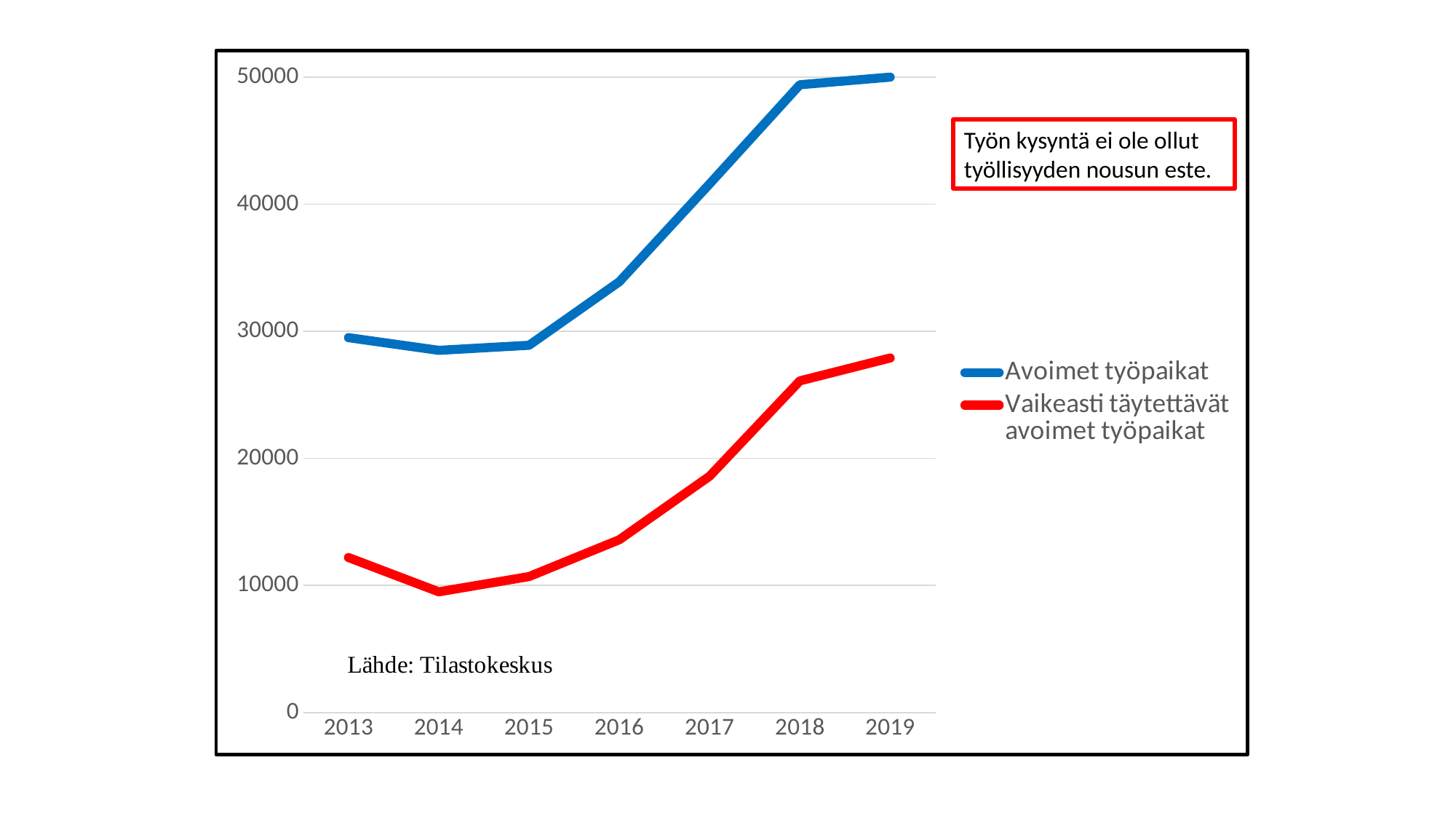
Do the values for Avoimet työpaikat rise or fall from 2015 to 2019? rise Which series has the larger value in 2016, Avoimet työpaikat or Vaikeasti täytettävät avoimet työpaikat? Avoimet työpaikat Which year has the lowest value for Vaikeasti täytettävät avoimet työpaikat? 2014 Is the value for Vaikeasti täytettävät avoimet työpaikat in 2018 greater or less than 20000? greater How many series does the legend list? 2 What colour is the line for Vaikeasti täytettävät avoimet työpaikat? red How many years are shown on the x axis? 7 Is the value for Avoimet työpaikat in 2017 greater or less than 40000? greater Which year has the highest value for Avoimet työpaikat? 2019 Is the value for Avoimet työpaikat in 2014 greater or less than 30000? less What kind of chart is shown on the slide? line chart